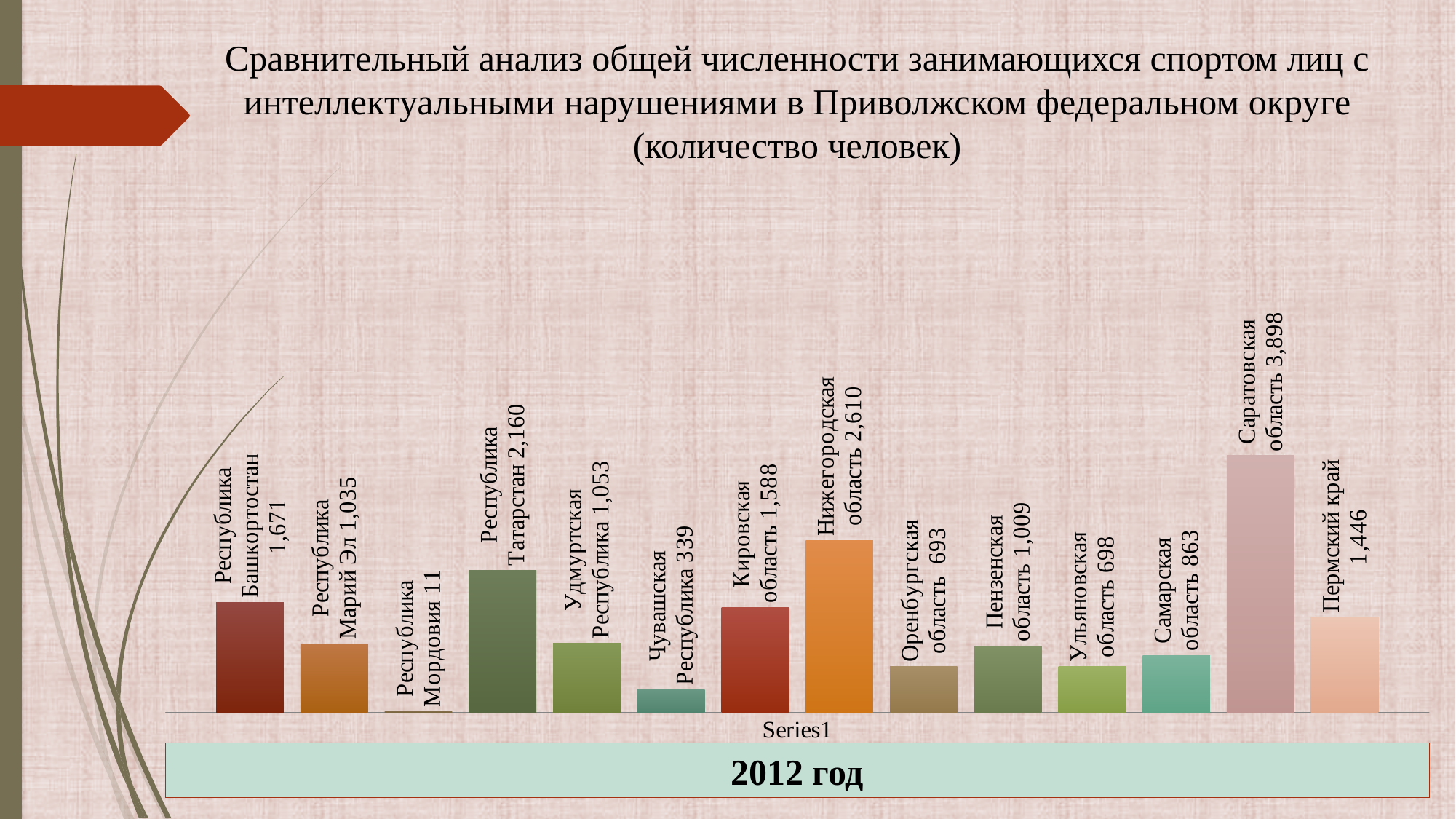
What is the value for Саратовская область? 3,898 What is the difference between the values for Республика Татарстан and Республика Башкортостан? 489 How many regions (bars) are shown in the chart? 14 Which region has the lowest value? Республика Мордовия What is the value for Пермский край? 1,446 Which region has the highest value? Саратовская область What is the value for Нижегородская область? 2,610 What kind of chart is shown on the slide? Bar chart What is the value for Республика Мордовия? 11 Which is larger, the value for Кировская область or the value for Пермский край? Кировская область What year is indicated below the chart? 2012 год What is the difference between the values for Саратовская область and Нижегородская область? 1,288